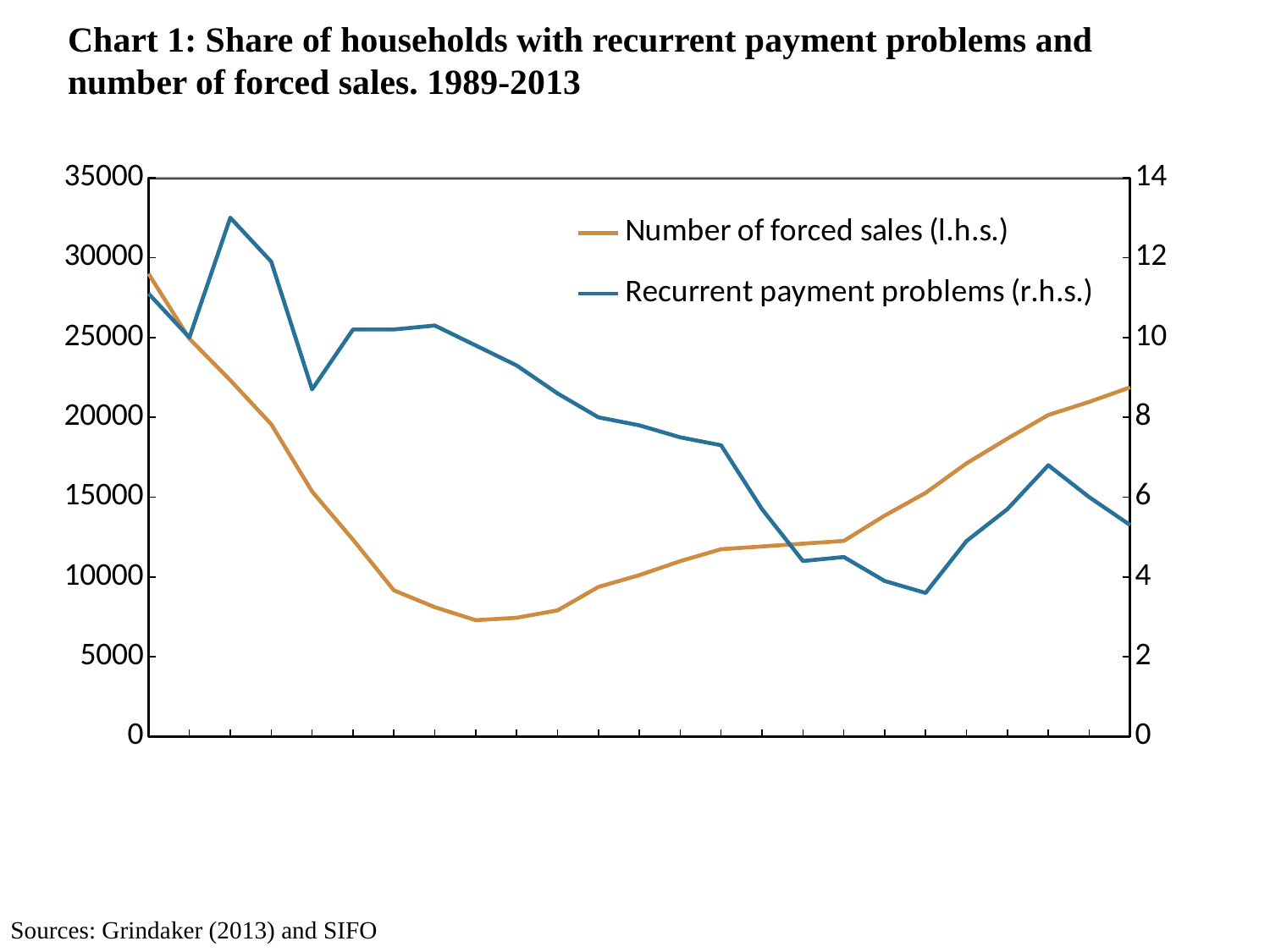
Which series is plotted against the right-hand axis? Recurrent payment problems (r.h.s.) How many series does the legend list? 2 Is the lowest value of the Recurrent payment problems series greater or less than 4? less Is the value of Number of forced sales at the end of the period greater or less than 20000? greater Does the Recurrent payment problems series overall rise or fall from the start to the end of the period? fall Is the value of Number of forced sales at the start of the period greater or less than 25000? greater Does the Number of forced sales series rise or fall over the second half of the period? rise What kind of chart is shown on the slide? line chart What is the maximum value shown on the left-hand axis? 35000